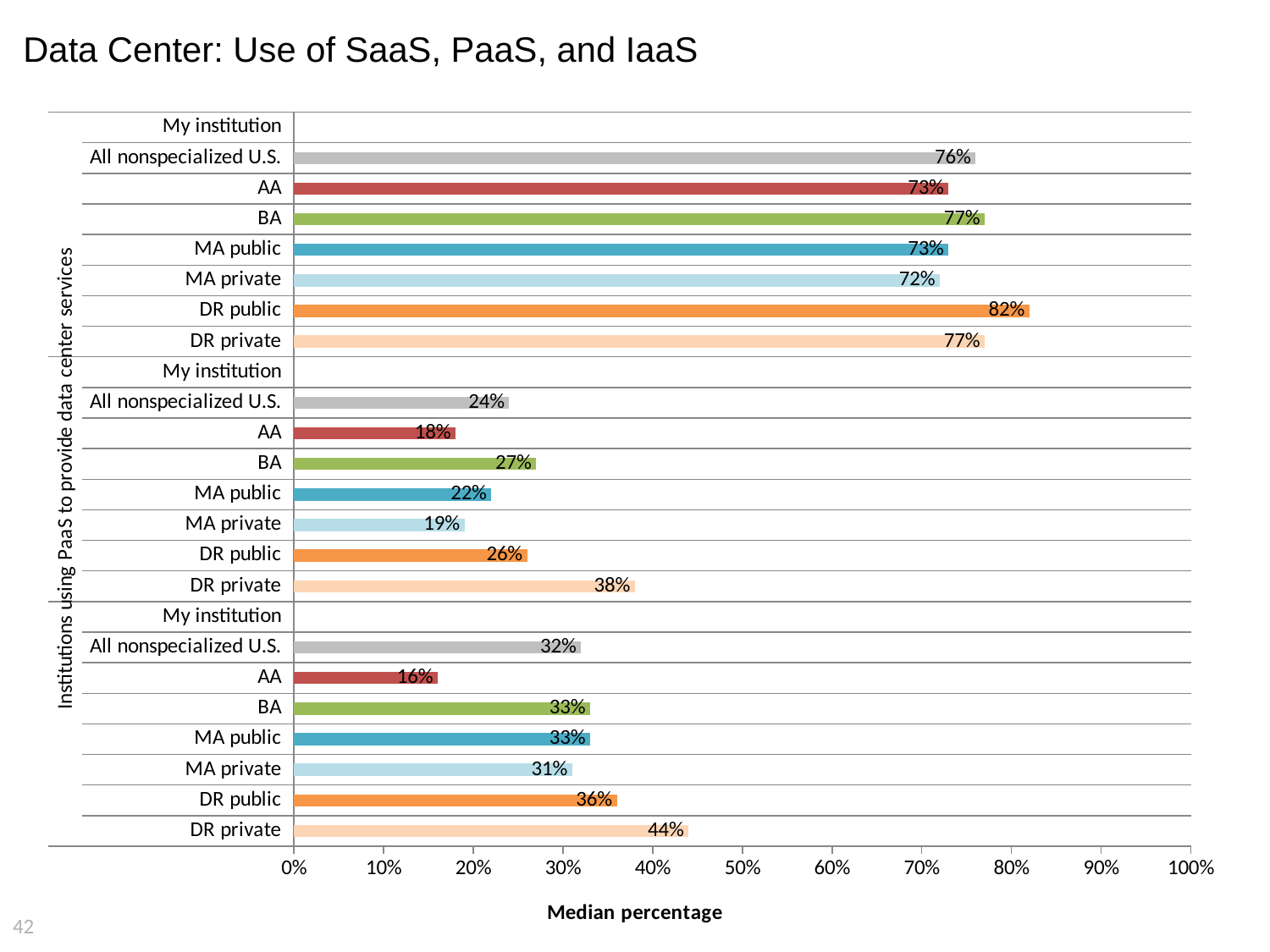
In the top group of bars, which category has the highest value? DR public In the top group of bars, what is the difference between DR public and MA private? 10% What kind of chart is shown on the slide? Bar chart In the middle group of bars, what is the value for All nonspecialized U.S.? 24% In the middle group of bars, what is the difference between DR private and AA? 20% In the top group of bars, is the value for BA greater or less than 70%? greater What is the x-axis title of the chart? Median percentage In the bottom group of bars, which is larger, DR public or MA private? DR public In the middle group of bars, which category has the highest value? DR private In the top group of bars, what is the value for DR public? 82% In the bottom group of bars, which category has the lowest value? AA In the bottom group of bars, what is the value for DR private? 44%